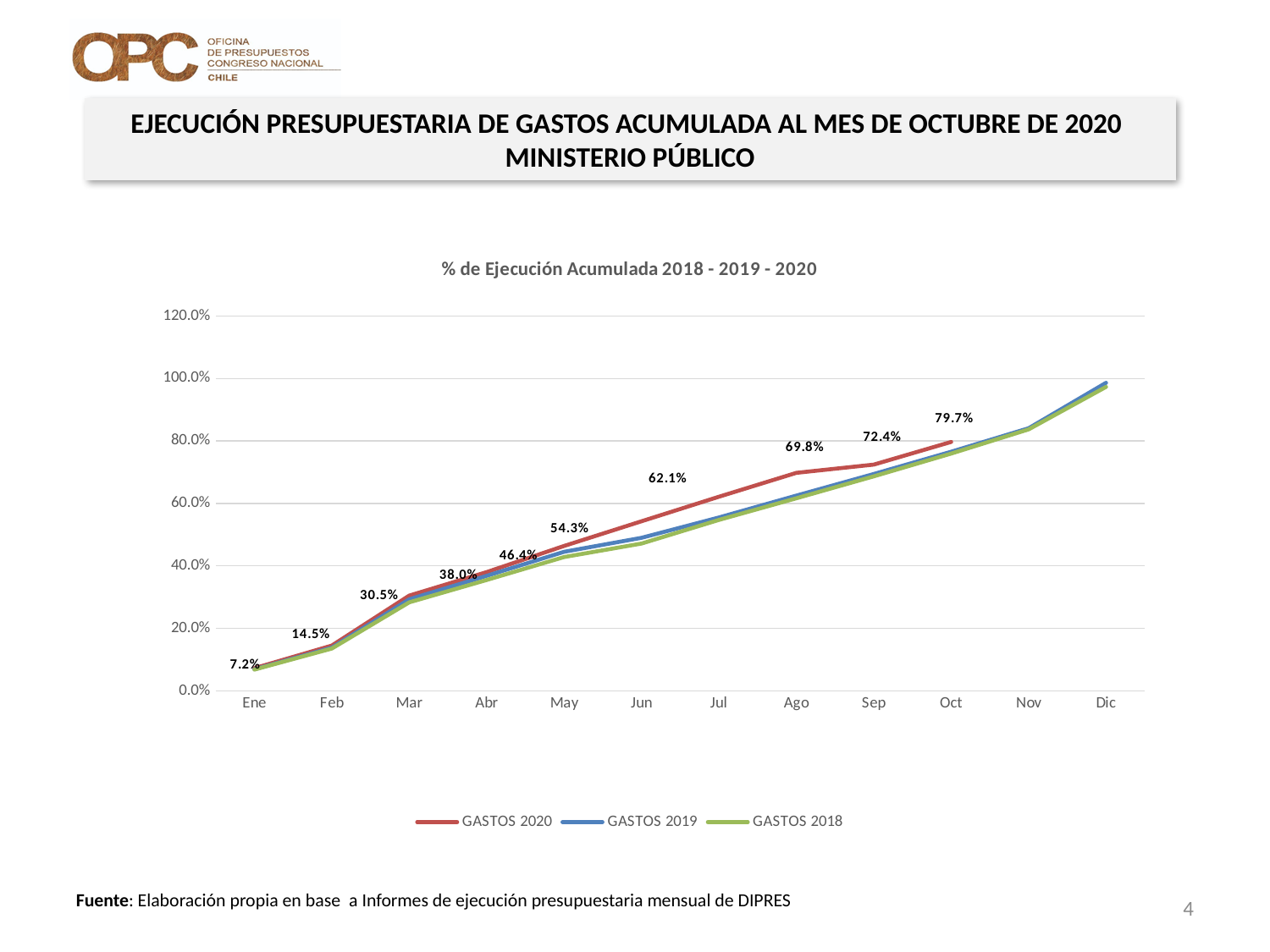
What is the value for GASTOS 2020 in Oct? 79.7% What type of chart is shown on the slide? Line chart Does the GASTOS 2020 line rise or fall from Ene to Oct? Rises What is the title of the chart? % de Ejecución Acumulada 2018 - 2019 - 2020 Is the value for GASTOS 2019 in Dic greater or less than 80.0%? greater What is the difference between the GASTOS 2020 values for Oct and Sep? 7.3% How many series does the legend list? 3 What is the value for GASTOS 2020 in Jun? 54.3% What is the value for GASTOS 2020 in Ene? 7.2% In Jul, which is larger: GASTOS 2020 or GASTOS 2018? GASTOS 2020 What is the difference between the GASTOS 2020 values for Mar and Feb? 16.0% What is the value for GASTOS 2020 in Ago? 69.8%